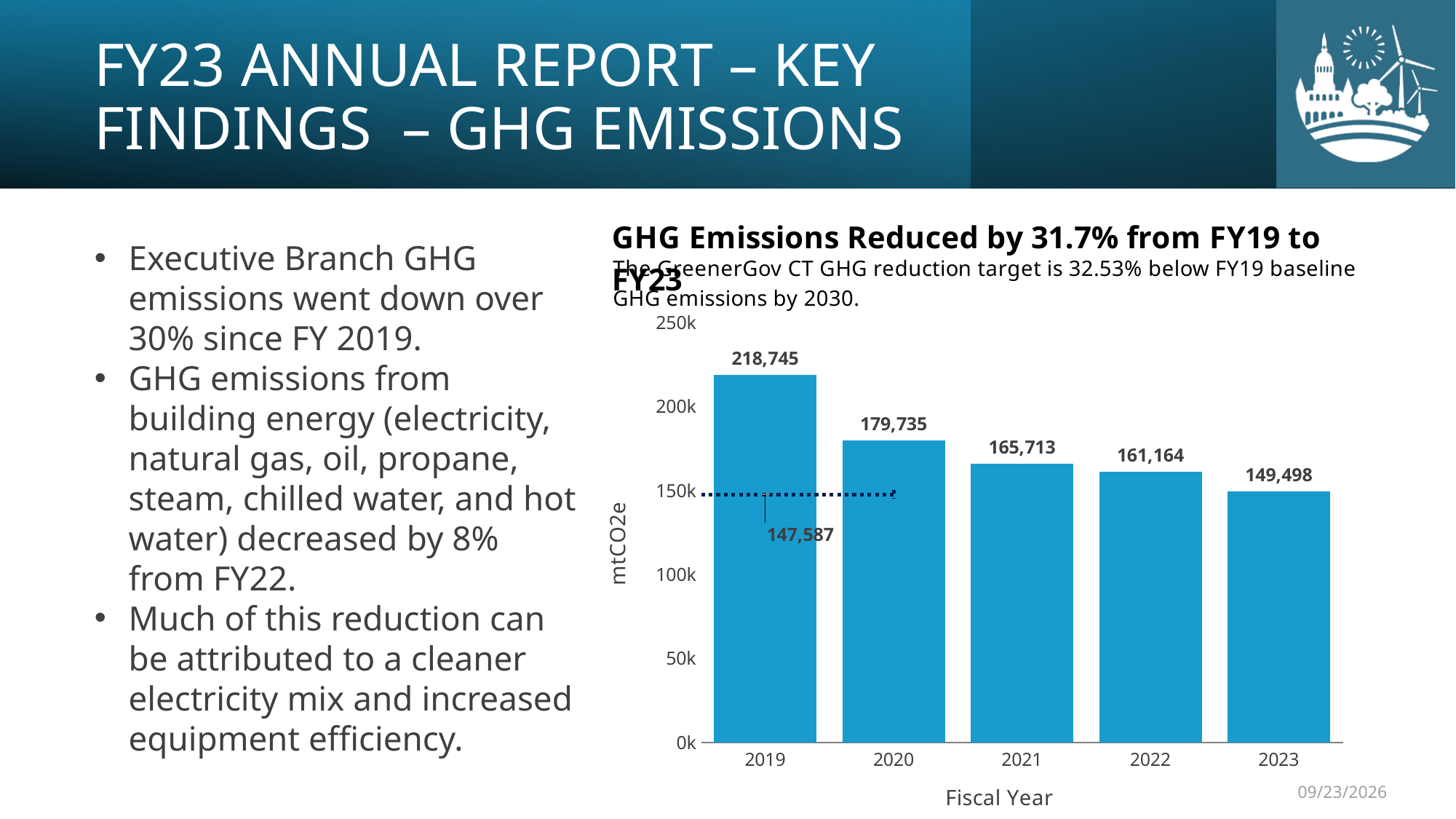
What kind of chart is used to show GHG emissions by fiscal year? bar chart What is the difference in GHG emissions between fiscal year 2020 and fiscal year 2021? 14,022 What was the GHG emissions value for fiscal year 2021? 165,713 Is the GHG emissions value for fiscal year 2023 greater or less than 150k? less How many fiscal years are shown on the x axis of the chart? 5 Which fiscal year has the highest GHG emissions? 2019 What was the GHG emissions value for fiscal year 2023? 149,498 What is the difference in GHG emissions between fiscal year 2019 and fiscal year 2023? 69,247 Do GHG emissions rise or fall from 2019 to 2023? fall Which fiscal year had higher GHG emissions, 2020 or 2022? 2020 Which fiscal year has the lowest GHG emissions? 2023 What was the GHG emissions value for fiscal year 2019? 218,745